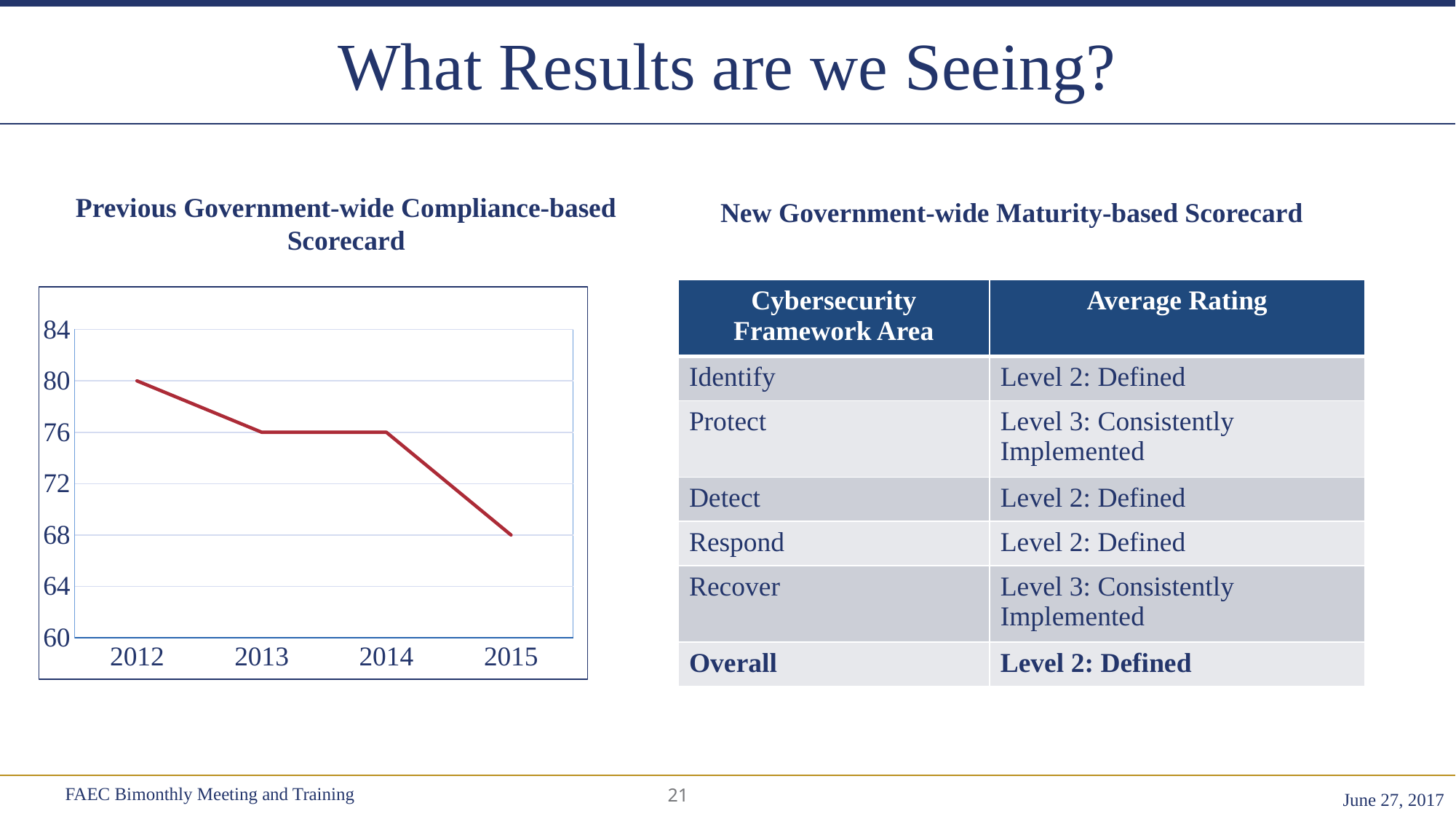
In the line chart, which year has the highest value? 2012 Do the values in the line chart rise or fall from 2012 to 2015? fall In the line chart, which year has the lowest value? 2015 In the line chart, is the value for 2012 larger or smaller than the value for 2014? larger In the line chart, is the value for 2015 greater or less than 72? less What type of chart is shown under the heading "Previous Government-wide Compliance-based Scorecard"? line chart In the line chart, what is the value for 2012? 80 In the line chart, what is the difference between the 2012 value and the 2015 value? 12 In the line chart, what is the value for 2013? 76 How many years are plotted on the x axis of the line chart? 4 What colour is the line in the line chart? red In the line chart, what is the value for 2015? 68